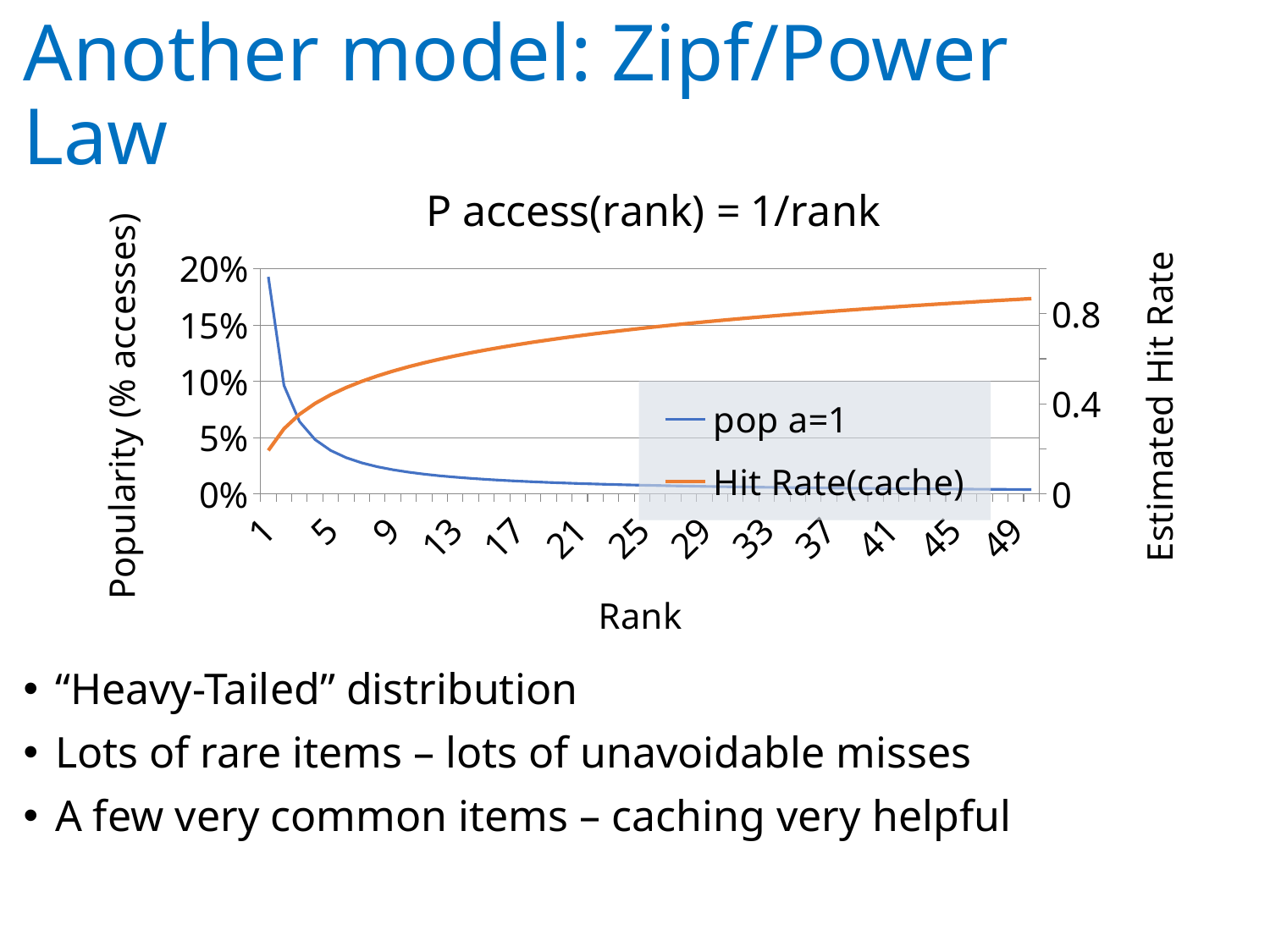
How many series does the legend list? 2 Is the 'pop a=1' value at rank 1 greater or less than 15%? greater Is the 'Hit Rate(cache)' value at rank 1 greater or less than 0.4? less What kind of chart is shown on the slide? Line chart At which rank is the 'Hit Rate(cache)' series lowest? 1 Does the 'pop a=1' series rise or fall as rank increases? Fall At which rank is the 'pop a=1' series highest? 1 What is the title of the chart? P access(rank) = 1/rank Is the 'Hit Rate(cache)' value at rank 49 greater or less than 0.8? greater Does the 'Hit Rate(cache)' series rise or fall as rank increases? Rise What is the label of the x axis? Rank